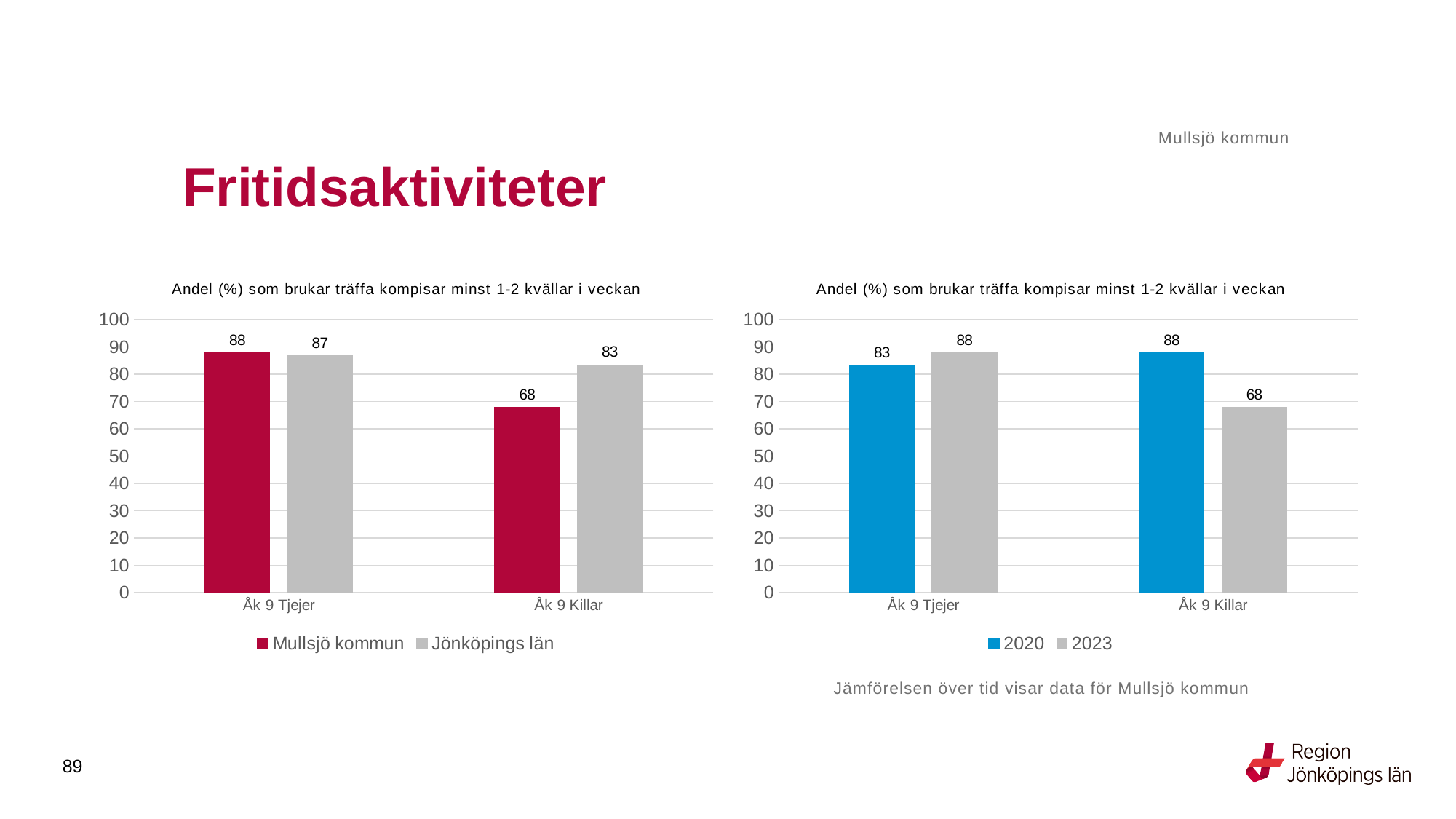
In the right chart, which is larger for Åk 9 Tjejer, 2020 or 2023? 2023 What are the legend entries of the left chart? Mullsjö kommun, Jönköpings län In the right chart, what is the value for 2023 for Åk 9 Killar? 68 In the left chart, what is the value for Jönköpings län for Åk 9 Killar? 83 In the right chart, is the value for 2023 for Åk 9 Killar greater or less than 70? less In the left chart, which category has the lowest value for Mullsjö kommun? Åk 9 Killar How many series does the legend of the right chart list? 2 In the right chart, what is the difference between 2020 and 2023 for Åk 9 Killar? 20 In the right chart, what is the value for 2020 for Åk 9 Tjejer? 83 What kind of chart is the left chart? bar chart In the left chart, what is the difference between Mullsjö kommun and Jönköpings län for Åk 9 Killar? 15 In the left chart, what is the value for Mullsjö kommun for Åk 9 Tjejer? 88